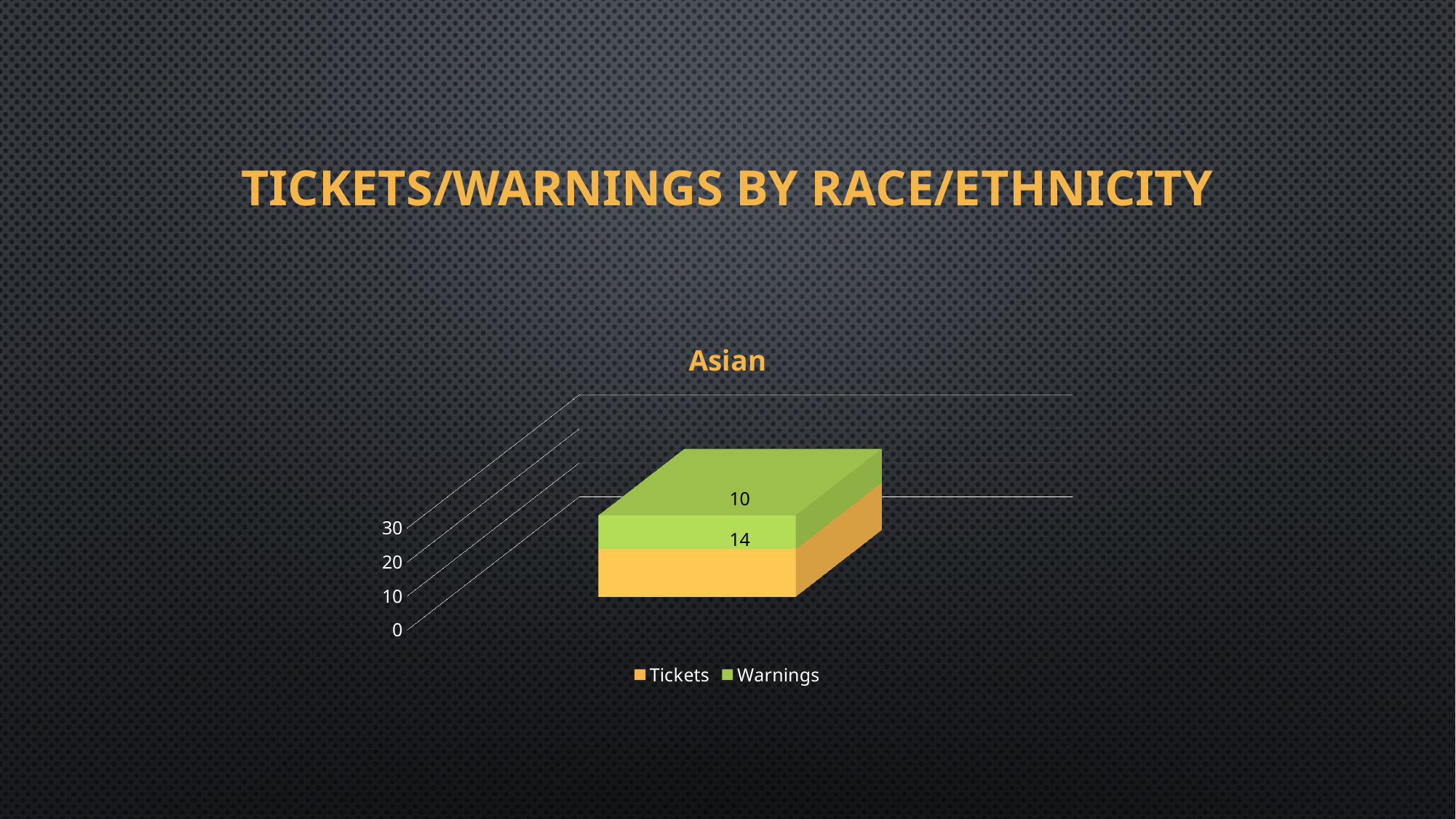
Which series has the smaller value in the chart? Warnings How many series does the legend list? 2 What is the title of the chart? Asian What is the value for Tickets in the Asian chart? 14 What is the total of the stacked bar for Asian? 24 Which colour represents Warnings in the legend? Green What is the difference between the Tickets value and the Warnings value? 4 What is the value for Warnings in the Asian chart? 10 Is the total of the stacked bar greater or less than 20? greater How many categories are plotted on the chart? 1 What kind of chart is shown on the slide? Stacked bar chart Which series has the larger value, Tickets or Warnings? Tickets